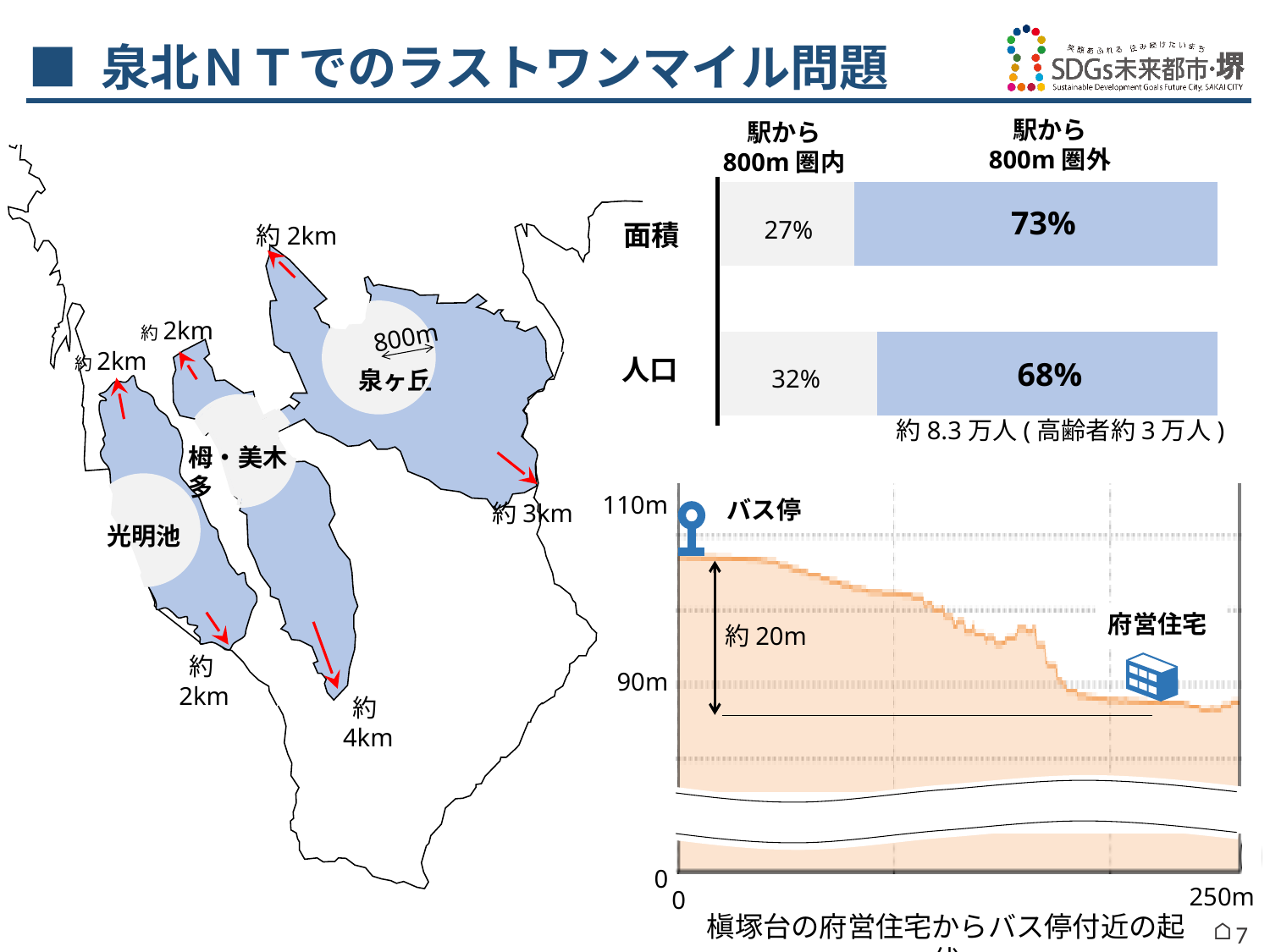
In the stacked bar chart at the top right, what percentage of 人口 (population) is 駅から800m圏内 (within 800m of a station)? 32% In the stacked bar chart at the top right, what percentage of 人口 (population) is 駅から800m圏外? 68% In the stacked bar chart at the top right, what percentage of 面積 (area) is 駅から800m圏内? 27% What kind of chart is the chart at the top right of the slide? Stacked bar chart How many series (segments per bar) does the stacked bar chart at the top right have? 2 In the stacked bar chart at the top right, what is the difference between the 駅から800m圏外 share of 面積 (73%) and of 人口 (68%)? 5% In the elevation profile chart at the bottom right, does the elevation rise or fall moving from the バス停 at 0 toward 250m? Fall In the stacked bar chart at the top right, what percentage of 面積 (area) is 駅から800m圏外 (outside 800m from a station)? 73% In the stacked bar chart at the top right, what is the total of the two segments of the 面積 bar? 100% In the elevation profile chart at the bottom right, what is the approximate height difference labelled between the バス停 (bus stop) and the 府営住宅? 約20m How many category bars does the stacked bar chart at the top right show? 2 In the stacked bar chart at the top right, which is larger: the 駅から800m圏外 share of 面積 or the 駅から800m圏外 share of 人口? 面積